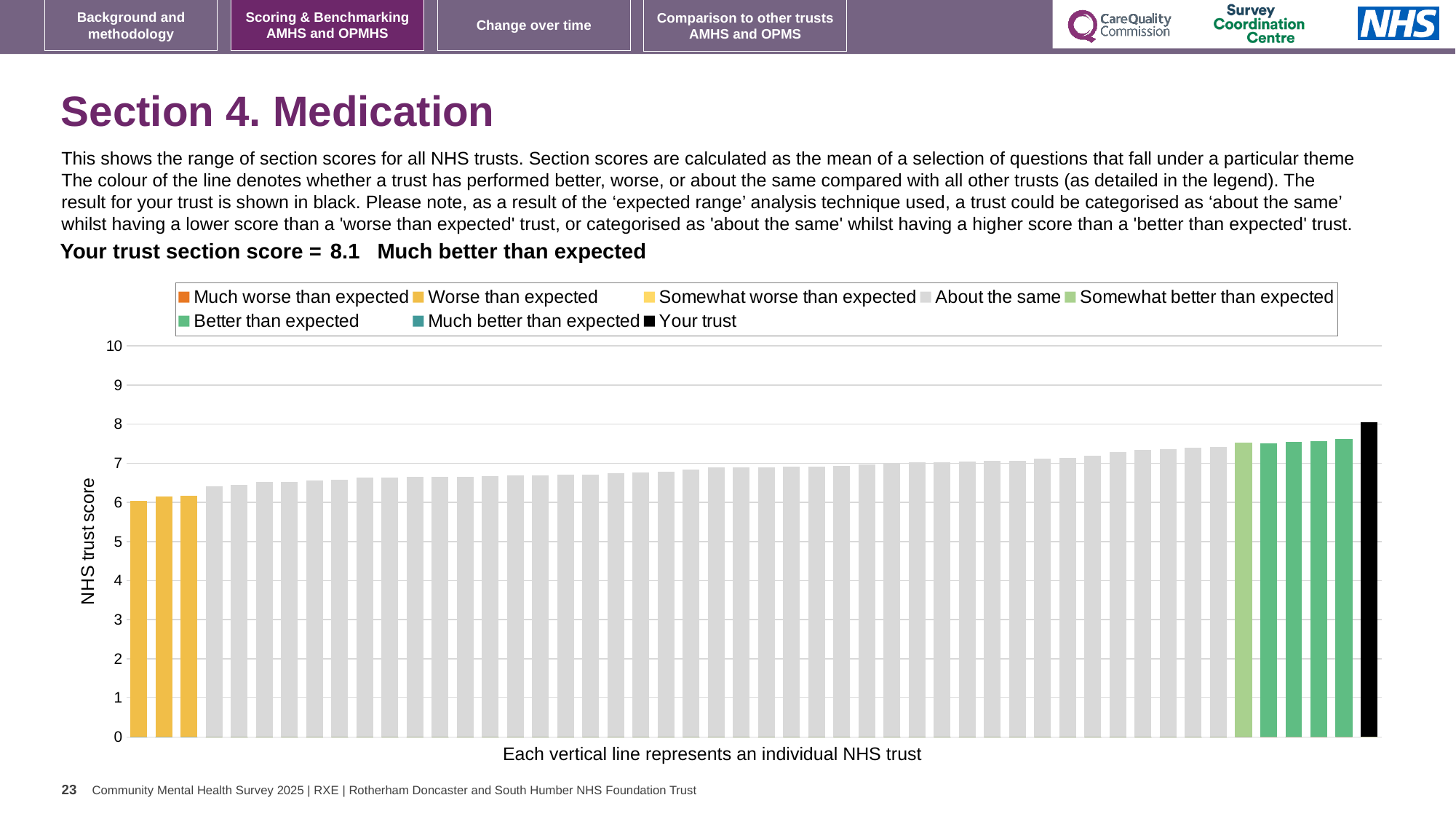
Do the bar values rise or fall from left to right along the x axis? rise What colour represents 'Your trust' in the chart legend? black How many bars are coloured in the 'Worse than expected' category? 3 Is the value of the black 'Your trust' bar greater or less than 7? greater What is the label on the y axis of the chart? NHS trust score Is the value of the leftmost bar greater or less than 5? greater How many entries does the chart legend list? 8 Which bar in the chart has the highest value? Your trust (the black bar) What type of chart is shown on the slide? bar chart How many bars are coloured in the 'Better than expected' category? 4 What is the section score for your trust shown on the slide? 8.1 Is the value of the leftmost bar greater or less than 7? less